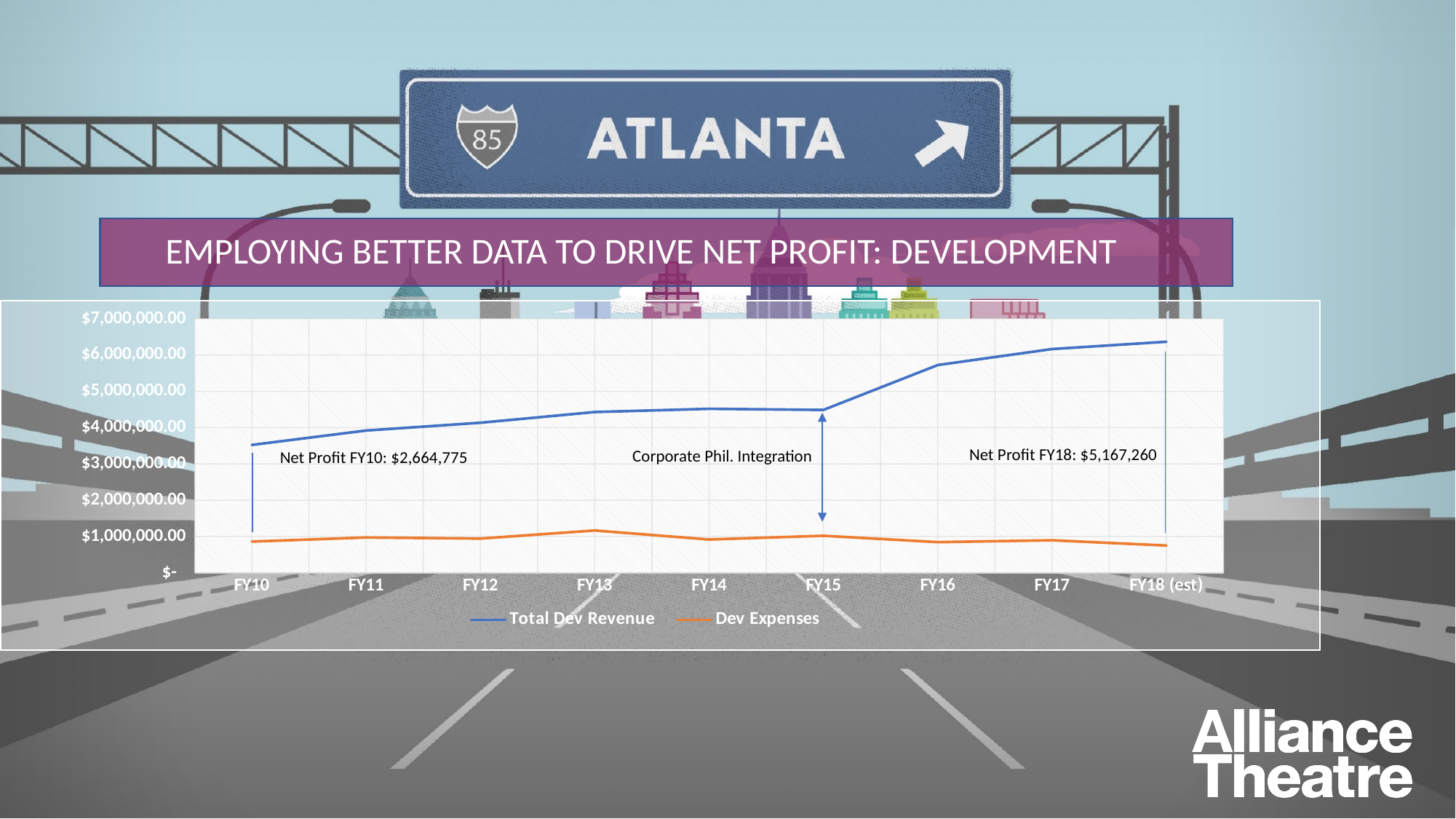
Which event is annotated on the chart at FY15? Corporate Phil. Integration According to the annotation on the chart, what was the Net Profit in FY10? $2,664,775 In which fiscal year is Total Dev Revenue highest? FY18 (est) What kind of chart is shown on the slide? Line chart Does Total Dev Revenue generally rise or fall from FY10 to FY18 (est)? Rise How many series does the chart's legend list? 2 According to the annotation on the chart, what is the Net Profit for FY18? $5,167,260 By how much does the annotated Net Profit for FY18 exceed the annotated Net Profit for FY10? $2,502,485 In which fiscal year is Total Dev Revenue lowest? FY10 Is the Dev Expenses value for FY18 (est) greater or less than $1,000,000.00? less How many fiscal years are plotted along the x axis of the chart? 9 Is the Total Dev Revenue value for FY18 (est) greater or less than $6,000,000.00? greater